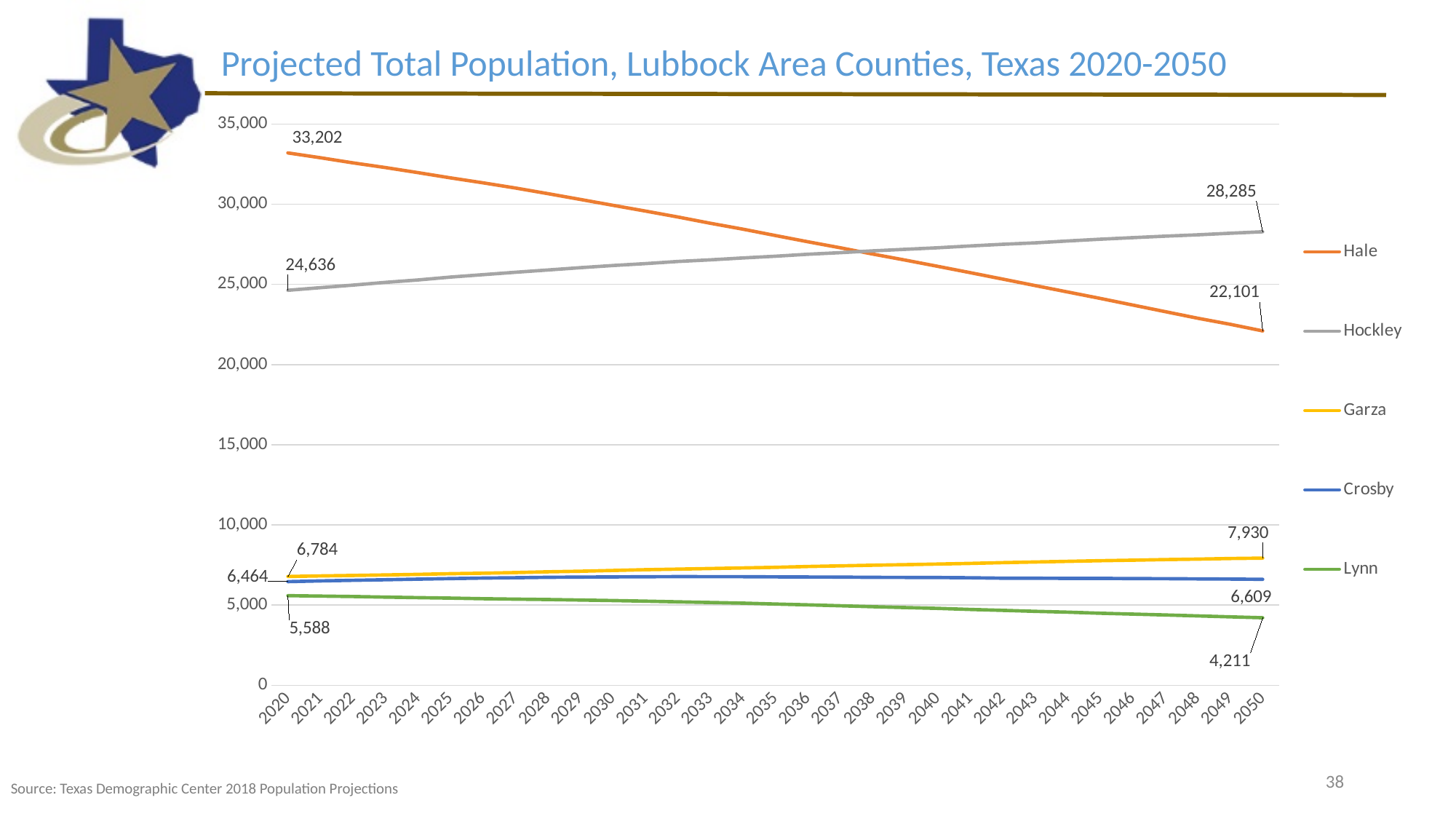
What is the projected population of Hockley County in 2050? 28,285 Which county has the lowest projected population in 2050? Lynn Does the projected population of Hale County rise or fall from 2020 to 2050? Fall Is the projected population of Hale County in 2035 greater or less than 25,000? greater What is the projected population of Hale County in 2020? 33,202 Which county has the highest projected population in 2020? Hale What type of chart is shown on the slide? Line chart By how much does Hockley County's projected population increase from 2020 to 2050? 3,649 What is the projected population of Lynn County in 2050? 4,211 In 2050, which county has the larger projected population, Garza or Crosby? Garza How many counties are listed in the legend? 5 By how much does Hale County's projected population decrease from 2020 to 2050? 11,101